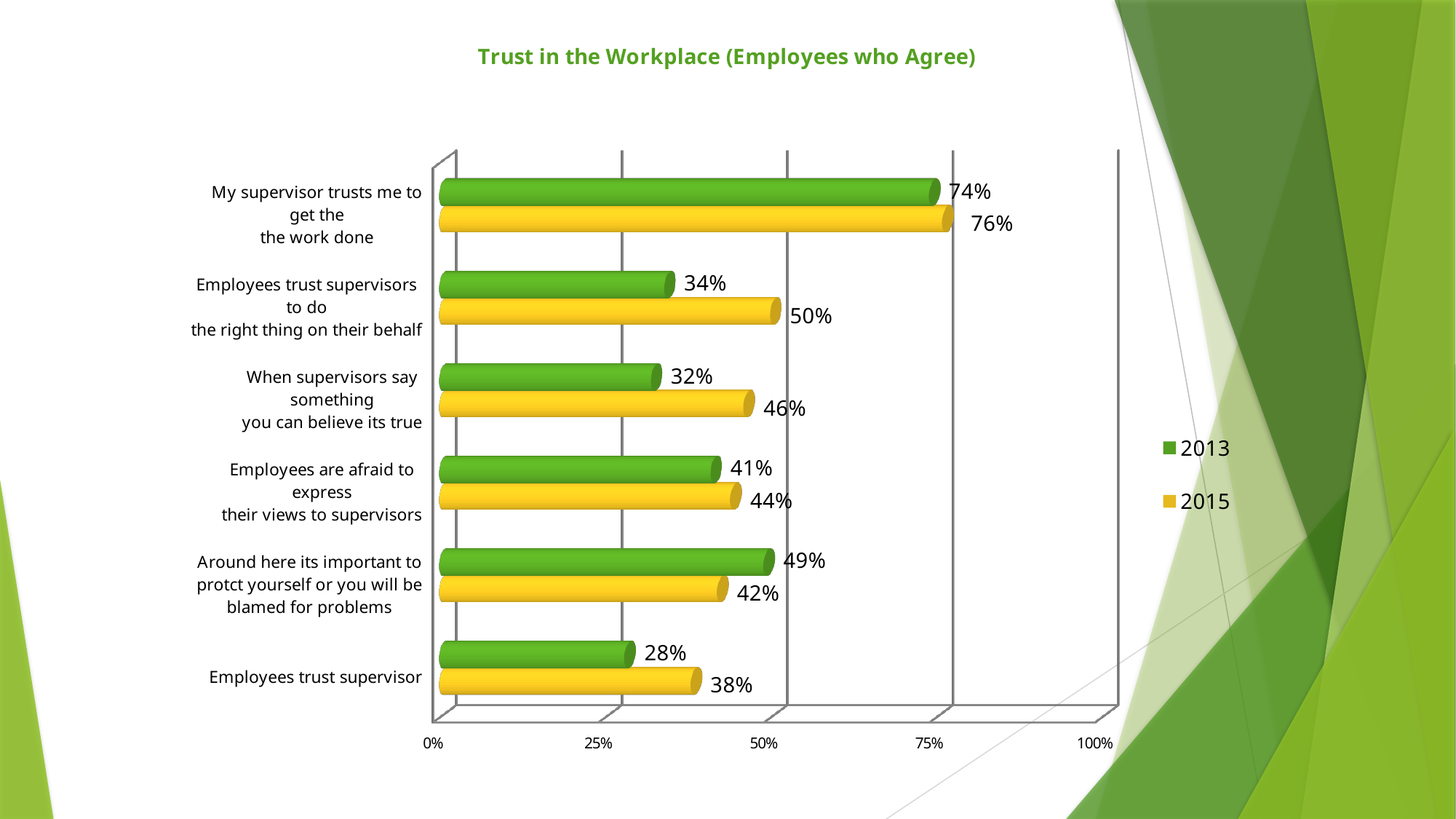
What kind of chart is shown on the slide? Bar chart How many categories are shown on the chart? 6 What is the 2013 value for "Around here its important to protct yourself or you will be blamed for problems"? 49% What is the difference between the 2015 and 2013 values for "When supervisors say something you can believe its true"? 14% Which category has the highest 2015 value? My supervisor trusts me to get the the work done What is the 2015 value for "Employees trust supervisors to do the right thing on their behalf"? 50% How many series does the legend list? 2 Is the 2015 value for "Employees trust supervisor" greater or less than 50%? less Which category has the lowest 2013 value? Employees trust supervisor For "Around here its important to protct yourself or you will be blamed for problems", which year has the larger value, 2013 or 2015? 2013 What is the title of the chart? Trust in the Workplace (Employees who Agree) What is the 2013 value for "Employees trust supervisor"? 28%